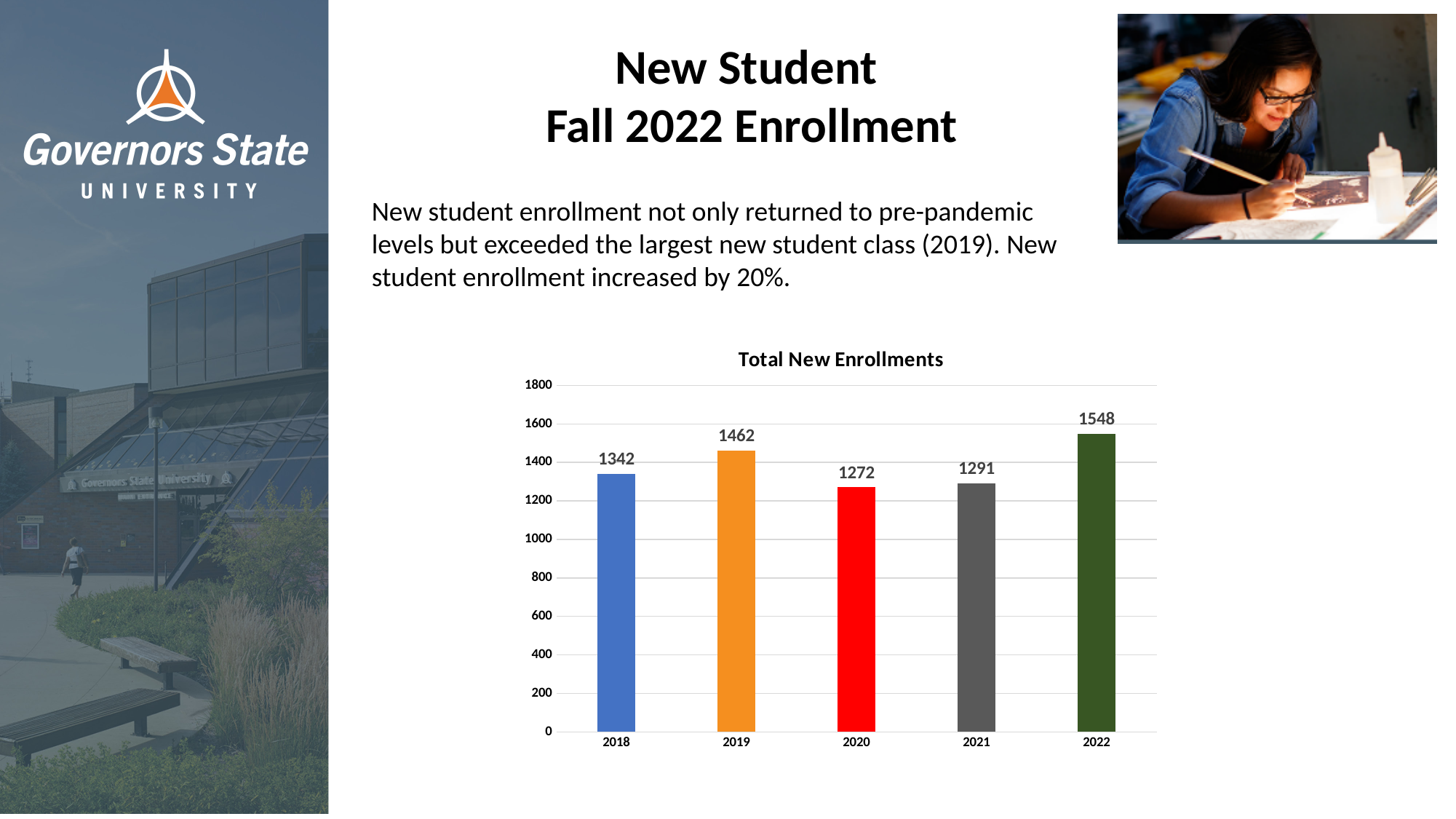
Which year has the lowest total new enrollments? 2020 Which year has the highest total new enrollments? 2022 What is the title of the chart on the slide? Total New Enrollments Which is larger, the value for 2019 or the value for 2018? 2019 Is the value for 2022 greater or less than 1400? greater What is the value for 2022 in the Total New Enrollments chart? 1548 What is the value for 2018 in the Total New Enrollments chart? 1342 What is the difference between the 2022 and 2019 values in the Total New Enrollments chart? 86 What kind of chart is used to show Total New Enrollments? bar chart What is the value for 2020 in the Total New Enrollments chart? 1272 How many years are shown in the Total New Enrollments chart? 5 What is the difference between the 2021 and 2020 values in the Total New Enrollments chart? 19